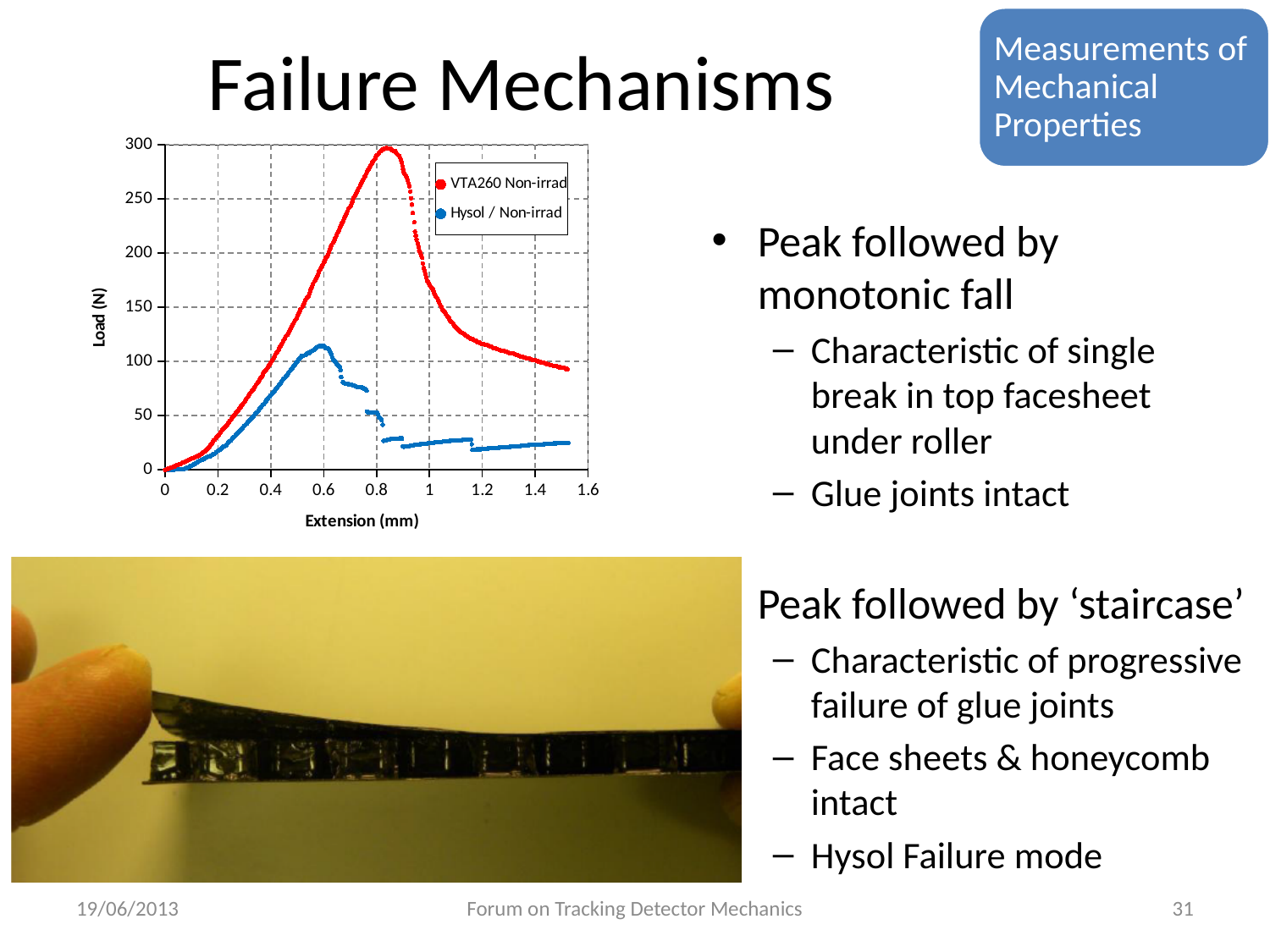
Is the load of the Hysol / Non-irrad series at an extension of 1.2 mm greater or less than 50 N? less How many series does the chart legend list? 2 Is the peak load of the VTA260 Non-irrad series greater or less than 250 N? greater Does the load of the VTA260 Non-irrad series rise or fall as extension increases from 1.0 mm to 1.5 mm? fall Is the peak load of the Hysol / Non-irrad series greater or less than 150 N? less What kind of chart is shown on the slide? Scatter chart Does the load of the Hysol / Non-irrad series rise or fall as extension increases from 0 to 0.5 mm? rise What are the two series named in the chart legend? VTA260 Non-irrad and Hysol / Non-irrad Which series has the higher load at an extension of 1.4 mm, VTA260 Non-irrad or Hysol / Non-irrad? VTA260 Non-irrad What is the label of the chart's y axis? Load (N) Which series reaches the higher peak load, VTA260 Non-irrad or Hysol / Non-irrad? VTA260 Non-irrad